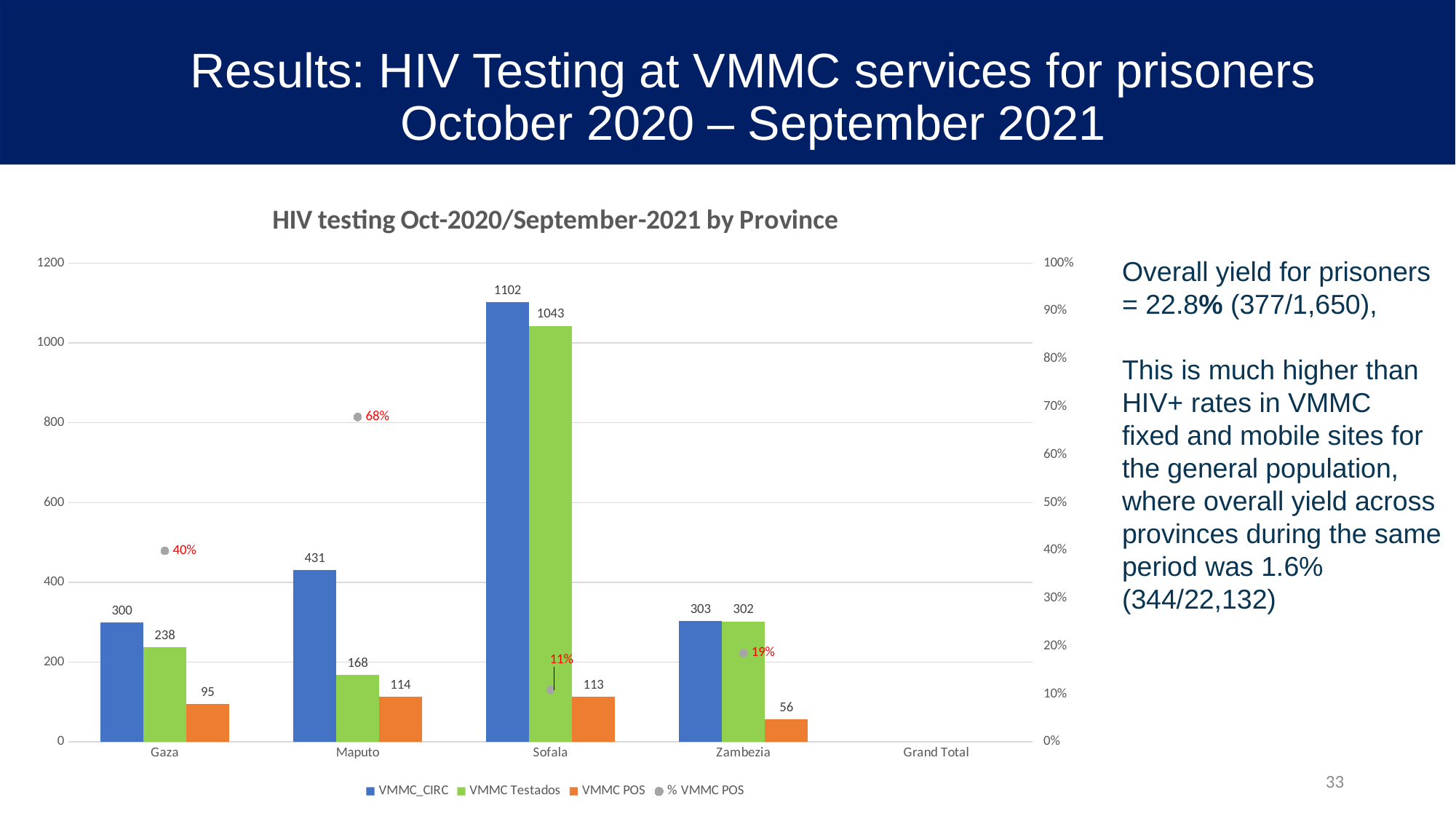
What kind of chart is shown on the slide? Bar chart with a line/marker series What is the % VMMC POS value for Maputo? 68% What is the VMMC Testados value for Maputo? 168 What is the VMMC_CIRC value for Sofala? 1102 How many series does the legend list? 4 What is the VMMC POS value for Zambezia? 56 What is the title of the chart? HIV testing Oct-2020/September-2021 by Province Which province has the highest VMMC_CIRC value? Sofala Which province has the lowest % VMMC POS value? Sofala Is the VMMC Testados value for Gaza greater or less than 200? greater Which is larger, the VMMC POS value for Gaza or for Maputo? Maputo What is the difference between the VMMC_CIRC and VMMC Testados values for Sofala? 59